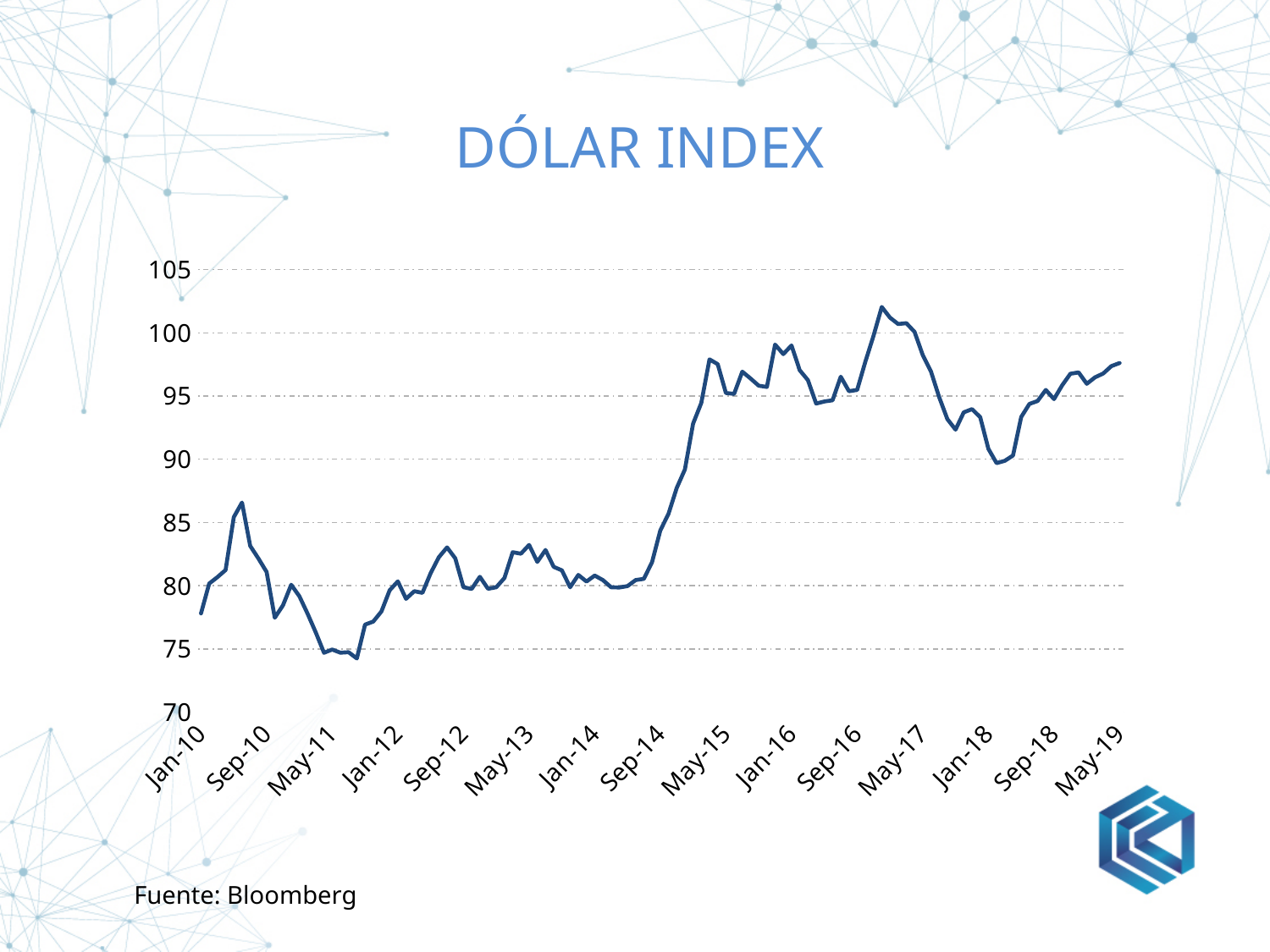
How many date labels are shown on the x axis? 15 Is the value at May-11 greater or less than 80? less Is the value at May-17 greater or less than 100? less Does the line rise or fall between Sep-14 and May-15? rise Is the value at May-19 greater or less than 95? greater Around which x-axis label does the line reach its lowest point? May-11 What kind of chart is shown on the slide? line chart What source is cited for the chart data? Bloomberg What is the title of the chart? DÓLAR INDEX Around which x-axis label does the line reach its highest point? Sep-16